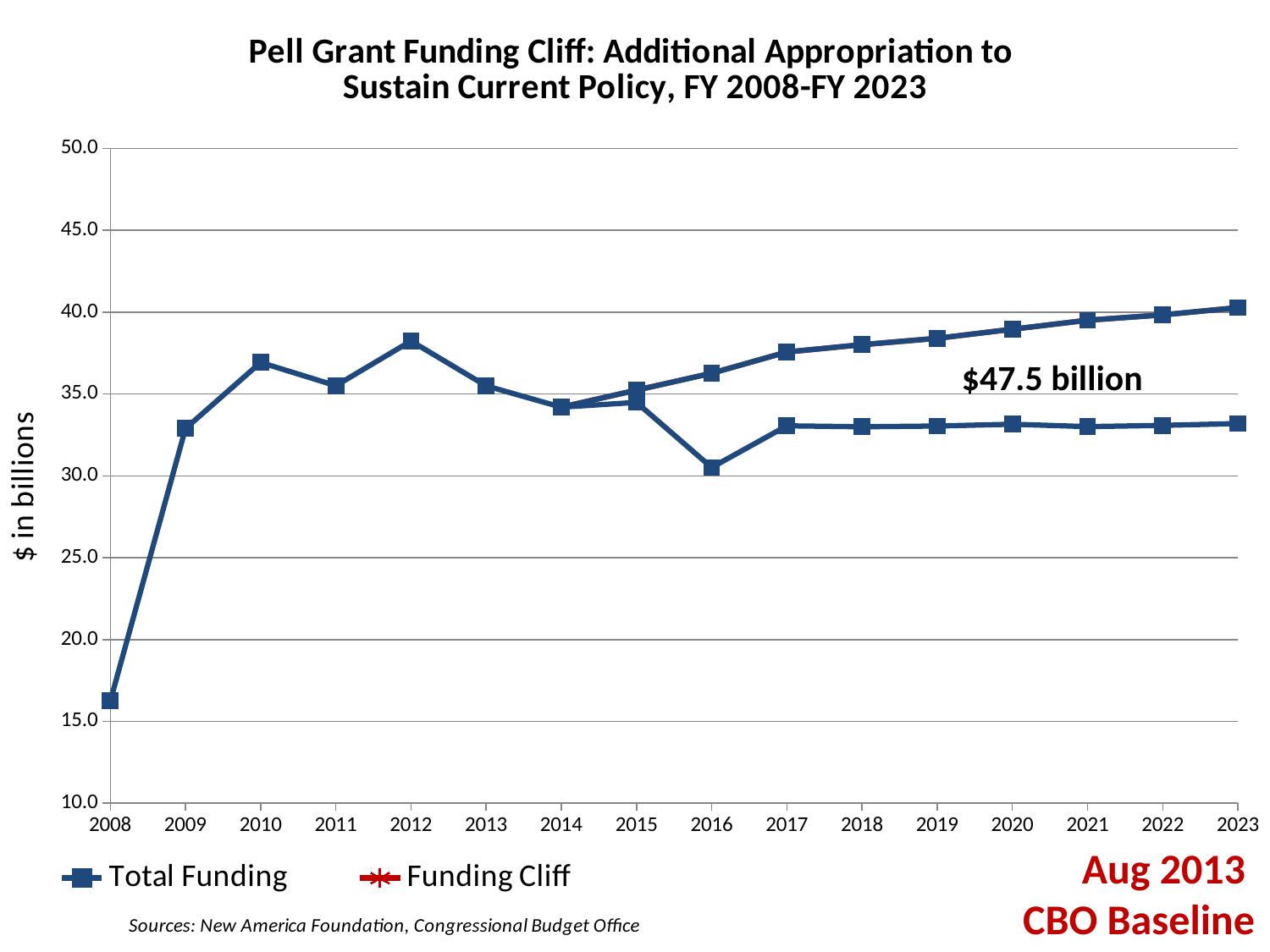
Is the lower line's value for 2023 greater or less than 35.0? less How many years are shown along the x axis? 16 Which year has the lowest value on the chart? 2008 Does the value rise or fall from 2008 to 2010? rise Is the value for 2010 greater or less than 35.0? greater Is the value for 2009 greater or less than 30.0? greater What is the label on the y axis? $ in billions How many series does the legend list? 2 What dollar amount is annotated on the chart between the two lines? $47.5 billion What kind of chart is shown on the slide? line chart